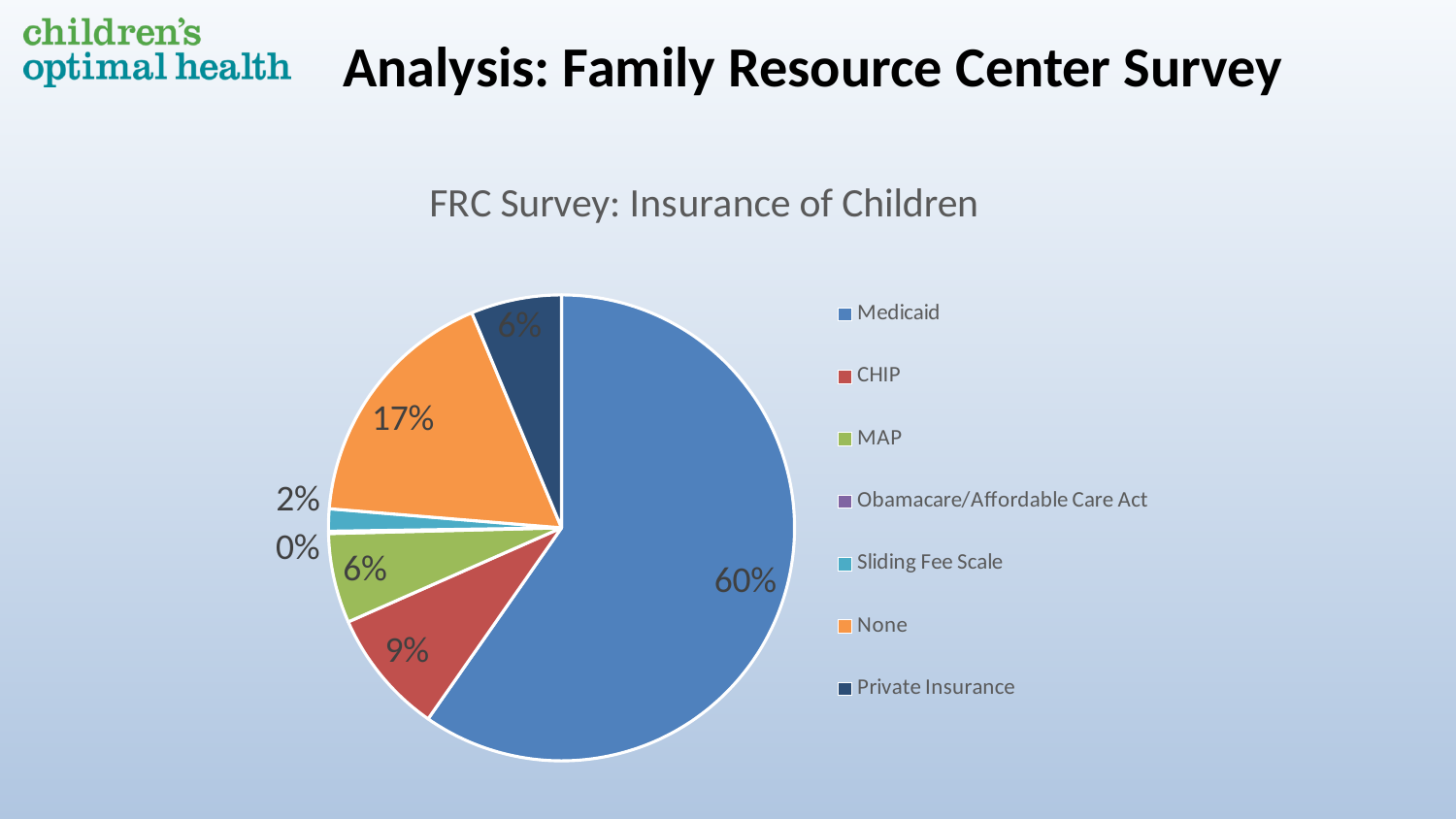
What percentage of children are covered by Medicaid? 60% What percentage of children are covered by CHIP? 9% What is the title of the chart? FRC Survey: Insurance of Children What kind of chart is shown on the slide? Pie chart Which insurance category has the smallest share of the pie? Obamacare/Affordable Care Act What is the difference in percentage points between Medicaid and None? 43 How many categories does the legend list? 7 Which insurance category has the largest share of the pie? Medicaid What percentage of children have no insurance (None)? 17% What percentage of children are covered by Obamacare/Affordable Care Act? 0% What percentage of children are covered by Sliding Fee Scale? 2% Which is larger, the share for CHIP or the share for MAP? CHIP